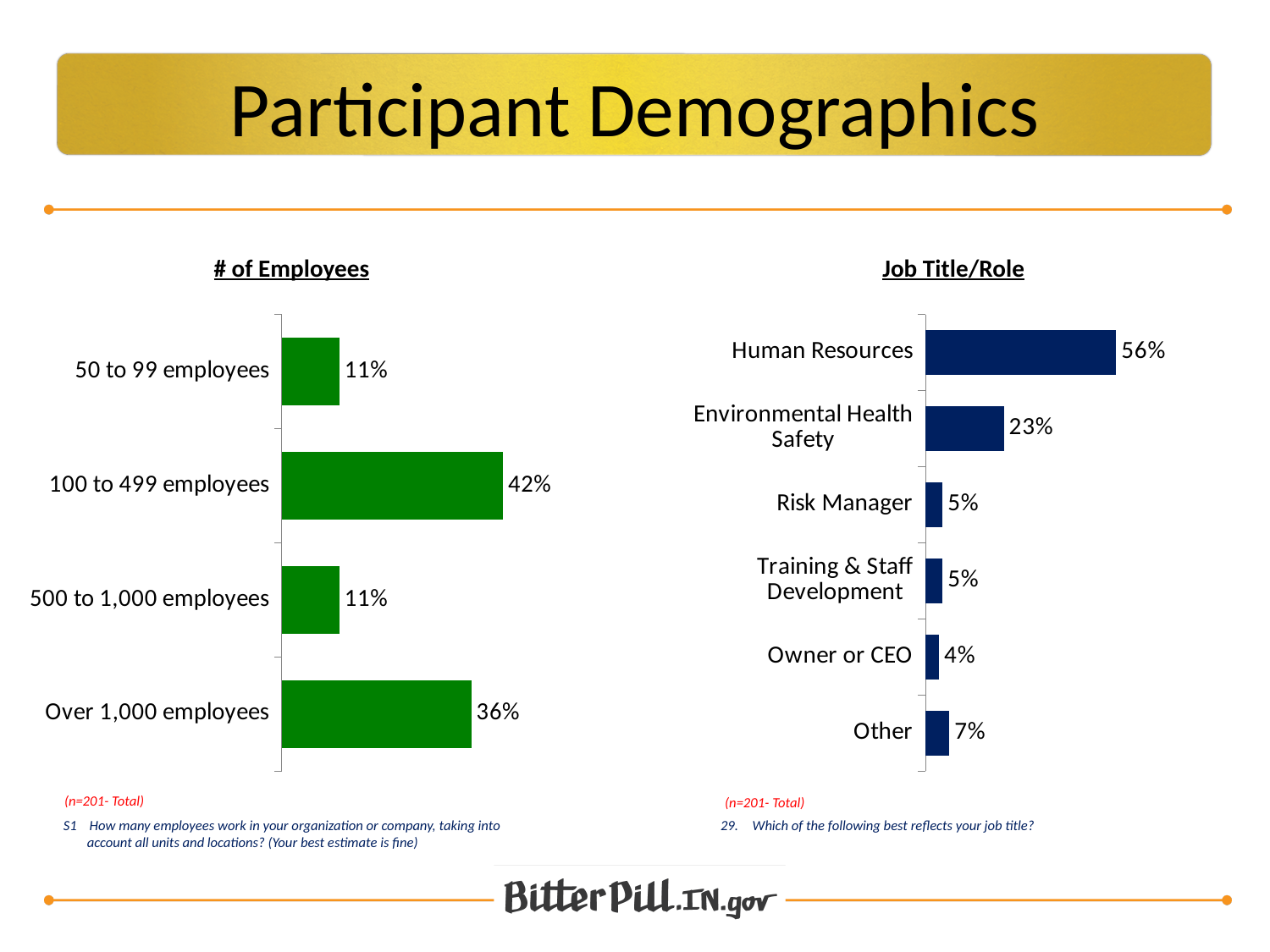
In the 'Job Title/Role' chart, which category has the lowest value? Owner or CEO In the 'Job Title/Role' chart, what is the difference between Human Resources and Environmental Health Safety? 33% What type of chart is the 'Job Title/Role' chart? Bar chart In the 'Job Title/Role' chart, what is the value for 'Environmental Health Safety'? 23% In the '# of Employees' chart, what percentage of participants have 100 to 499 employees? 42% In the '# of Employees' chart, which category has the highest value? 100 to 499 employees In the 'Job Title/Role' chart, which is larger: 'Other' or 'Owner or CEO'? Other In the '# of Employees' chart, what is the difference between '100 to 499 employees' and 'Over 1,000 employees'? 6% In the '# of Employees' chart, how many categories are shown? 4 In the 'Job Title/Role' chart, which category has the highest value? Human Resources In the '# of Employees' chart, what is the value for 'Over 1,000 employees'? 36% In the 'Job Title/Role' chart, what percentage of participants are in Human Resources? 56%